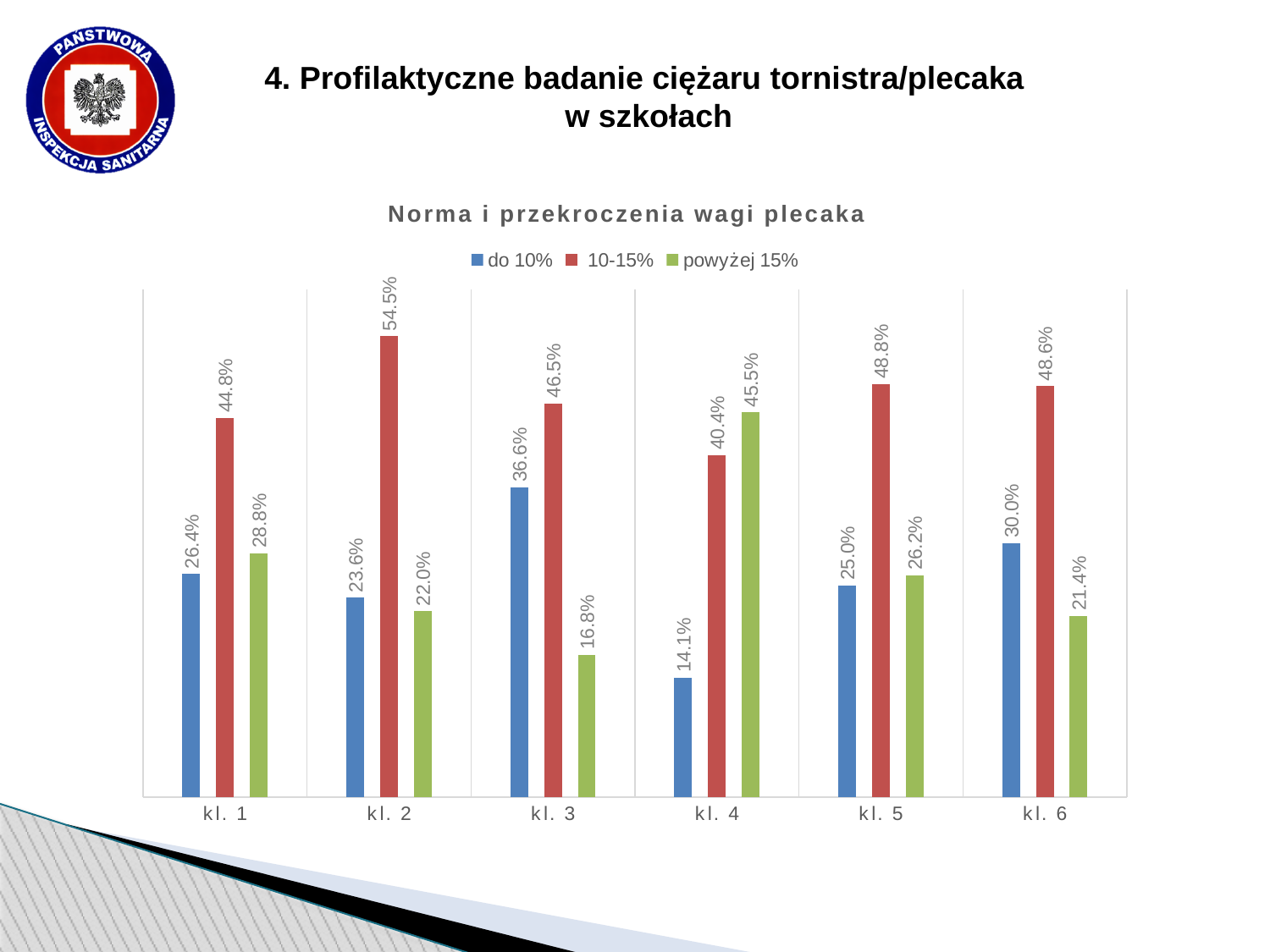
In kl. 4, which is larger: the "10-15%" value or the "powyżej 15%" value? powyżej 15% Which class has the highest value for the "powyżej 15%" series? kl. 4 Which class has the highest value for the "10-15%" series? kl. 2 What is the difference between the "10-15%" value and the "do 10%" value in kl. 1? 18.4% What is the title of the chart? Norma i przekroczenia wagi plecaka Which class has the lowest value for the "do 10%" series? kl. 4 What kind of chart is shown on the slide? bar chart What is the value for "powyżej 15%" in kl. 3? 16.8% What is the value for "10-15%" in kl. 2? 54.5% What is the value for "do 10%" in kl. 4? 14.1% How many classes (categories) are shown on the x axis? 6 How many series does the legend list? 3